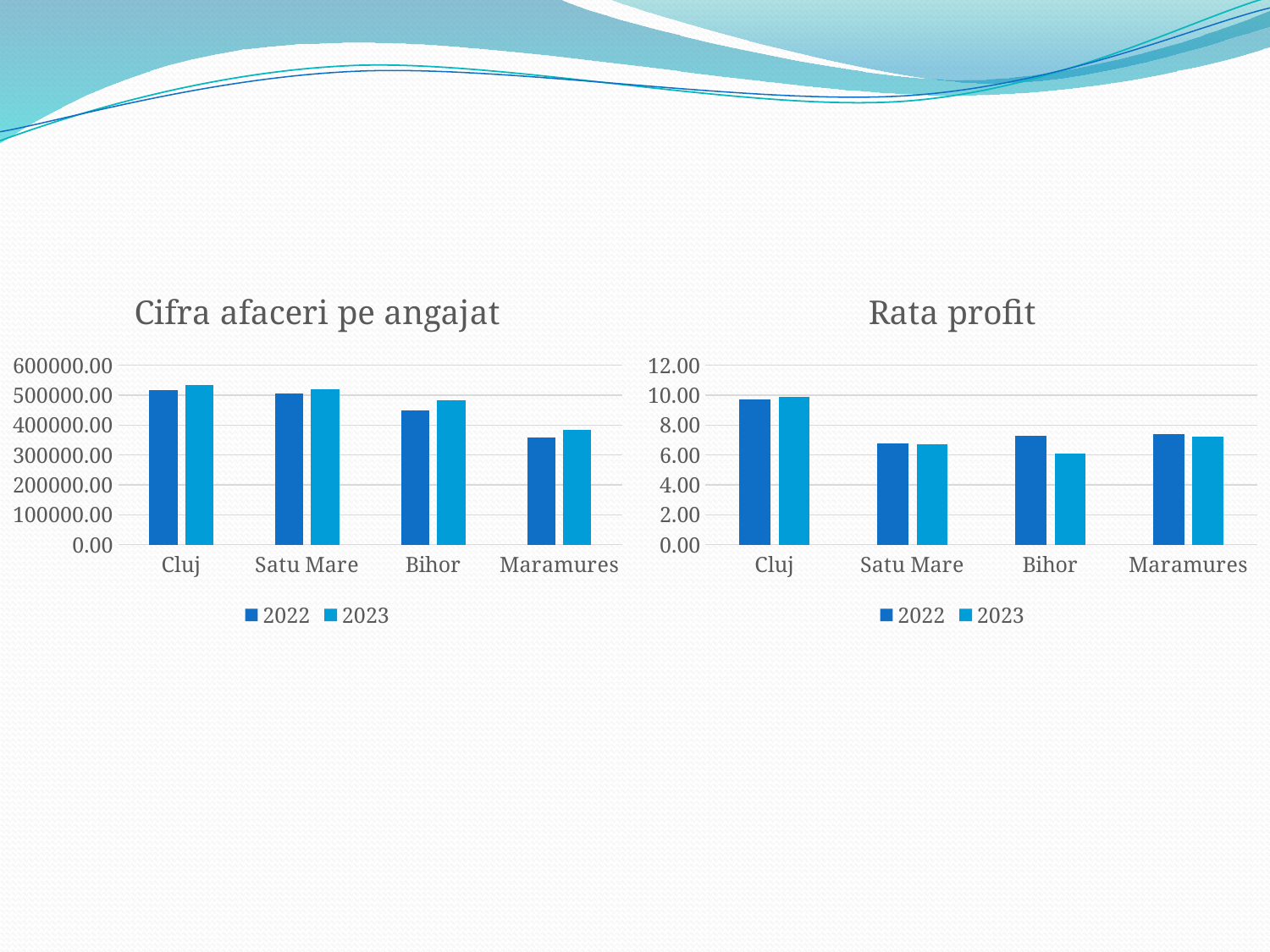
What kind of chart is the 'Cifra afaceri pe angajat' chart? bar chart In the 'Cifra afaceri pe angajat' chart, is the value for Maramures in 2022 greater or less than 400000.00? less In the 'Rata profit' chart, which year has the larger value for Bihor, 2022 or 2023? 2022 In the 'Cifra afaceri pe angajat' chart, which year has the larger value for Bihor, 2022 or 2023? 2023 In the 'Cifra afaceri pe angajat' chart, which category has the lowest value for 2023? Maramures In the 'Rata profit' chart, is the value for Bihor in 2023 greater or less than 8.00? less In the 'Rata profit' chart, which category has the highest value for 2022? Cluj In the 'Rata profit' chart, is the value for Cluj in 2022 greater or less than 8.00? greater How many categories are shown on the x axis of the 'Cifra afaceri pe angajat' chart? 4 What are the legend entries of the 'Cifra afaceri pe angajat' chart? 2022 and 2023 How many series does the legend of the 'Rata profit' chart list? 2